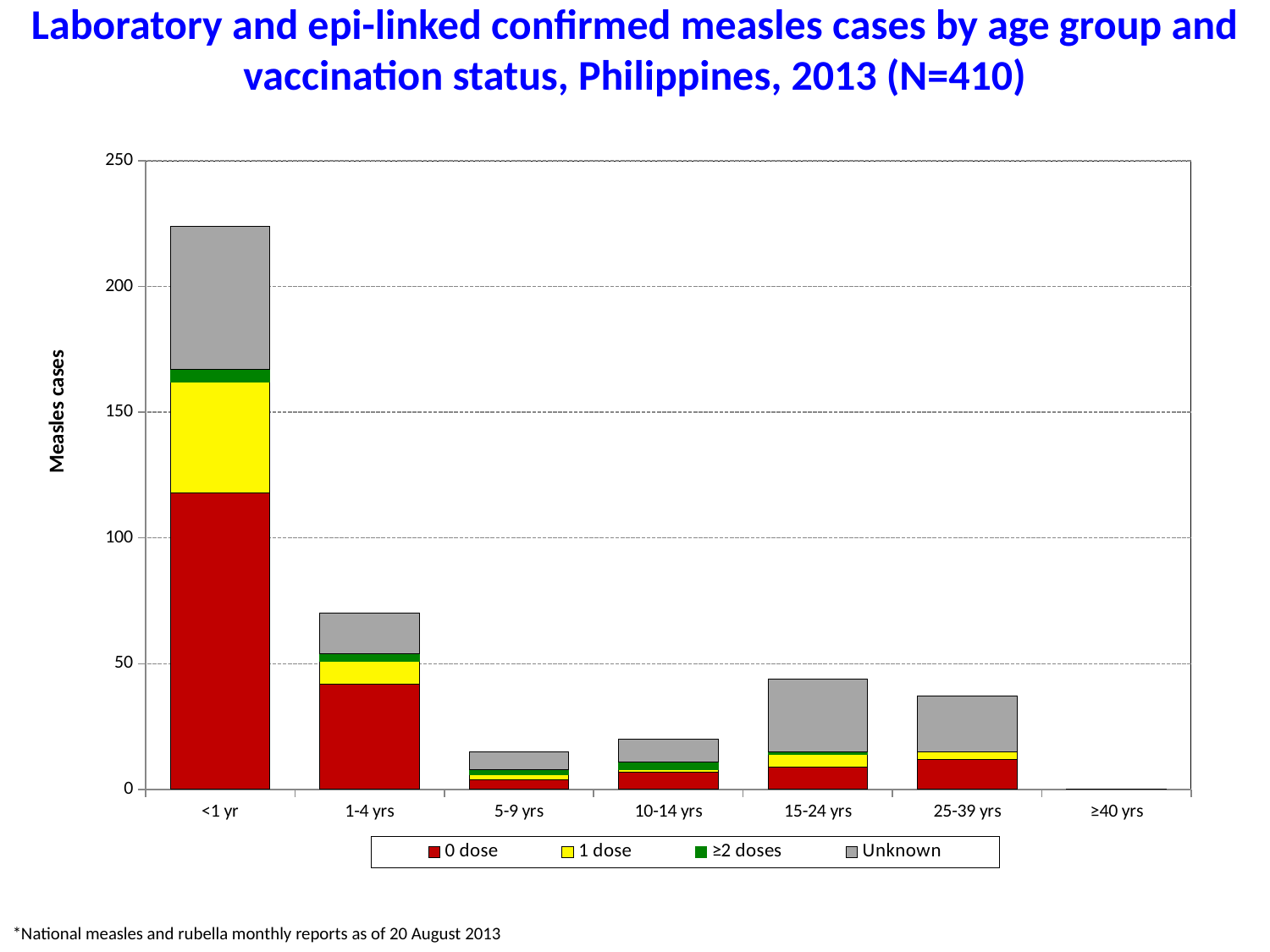
Which series is shown in grey in the chart? Unknown Is the total number of measles cases for the <1 yr age group greater or less than 200? greater What is the label of the y axis? Measles cases Which age group has the highest total number of measles cases? <1 yr How many series does the legend list? 4 Which age group has more total measles cases, 1-4 yrs or 15-24 yrs? 1-4 yrs Is the number of 0 dose measles cases in the <1 yr age group greater or less than 100? greater Is the total number of measles cases for the 1-4 yrs age group greater or less than 50? greater How many age groups are shown on the x axis? 7 Which age group has the lowest total number of measles cases? ≥40 yrs What kind of chart is shown on the slide? stacked bar chart